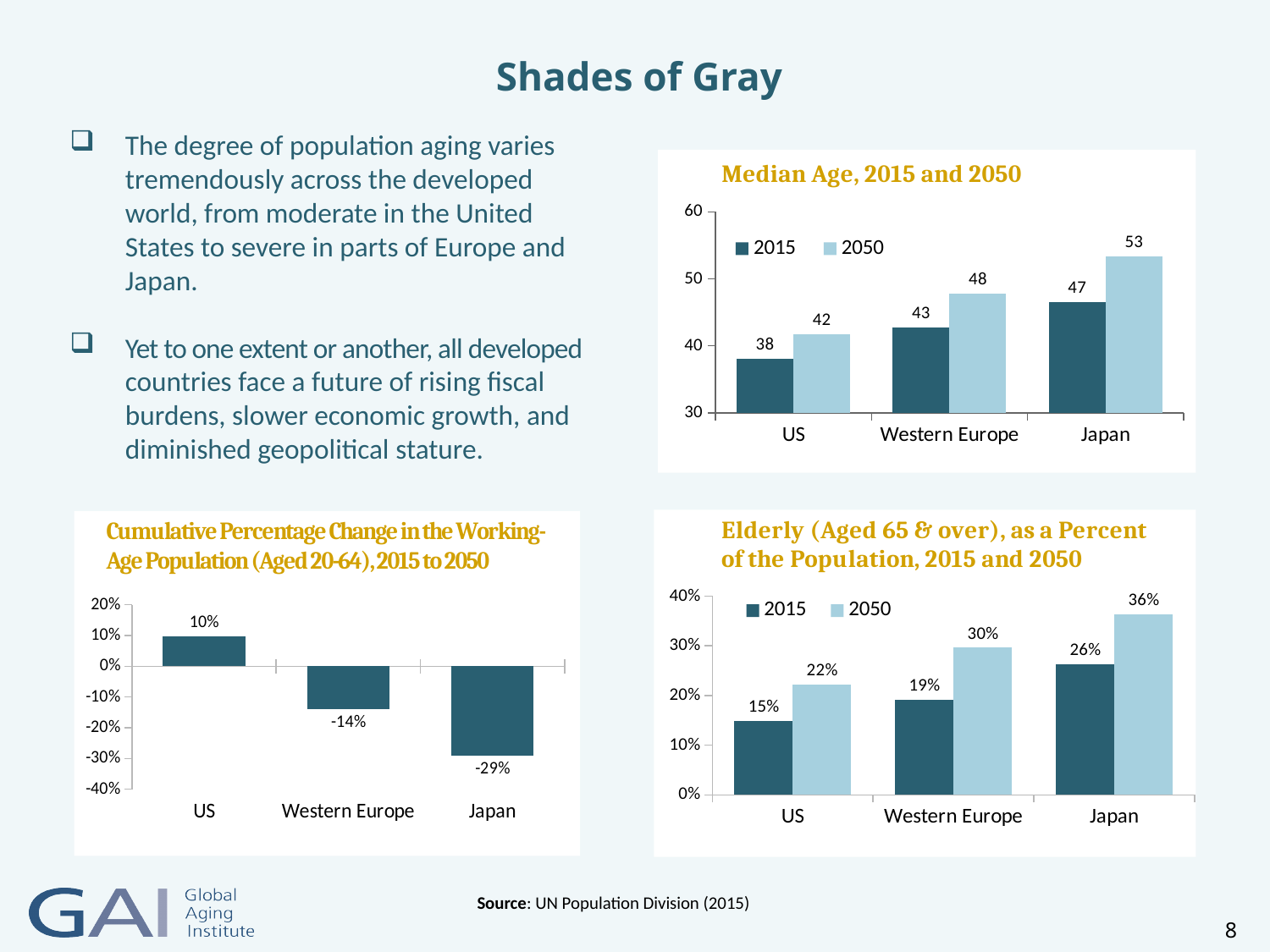
What kind of chart is the 'Cumulative Percentage Change in the Working-Age Population' chart? Bar chart In the 'Elderly (Aged 65 & over), as a Percent of the Population' chart, which is larger: the US 2050 value or the Japan 2015 value? Japan 2015 In the 'Median Age, 2015 and 2050' chart, what is the difference between Western Europe's 2050 and 2015 values? 5 In the 'Cumulative Percentage Change in the Working-Age Population' chart, how many categories are shown? 3 In the 'Median Age, 2015 and 2050' chart, what is the median age for Japan in 2050? 53 In the 'Elderly (Aged 65 & over), as a Percent of the Population' chart, what is the value for Western Europe in 2050? 30% In the 'Median Age, 2015 and 2050' chart, which category has the highest 2050 value? Japan In the 'Cumulative Percentage Change in the Working-Age Population' chart, which category has the lowest value? Japan In the 'Cumulative Percentage Change in the Working-Age Population' chart, what is the value for Japan? -29% In the 'Median Age, 2015 and 2050' chart, what is the median age for the US in 2015? 38 In the 'Elderly (Aged 65 & over), as a Percent of the Population' chart, what is the difference between Japan's 2050 and 2015 values? 10% In the 'Median Age, 2015 and 2050' chart, how many series does the legend list? 2